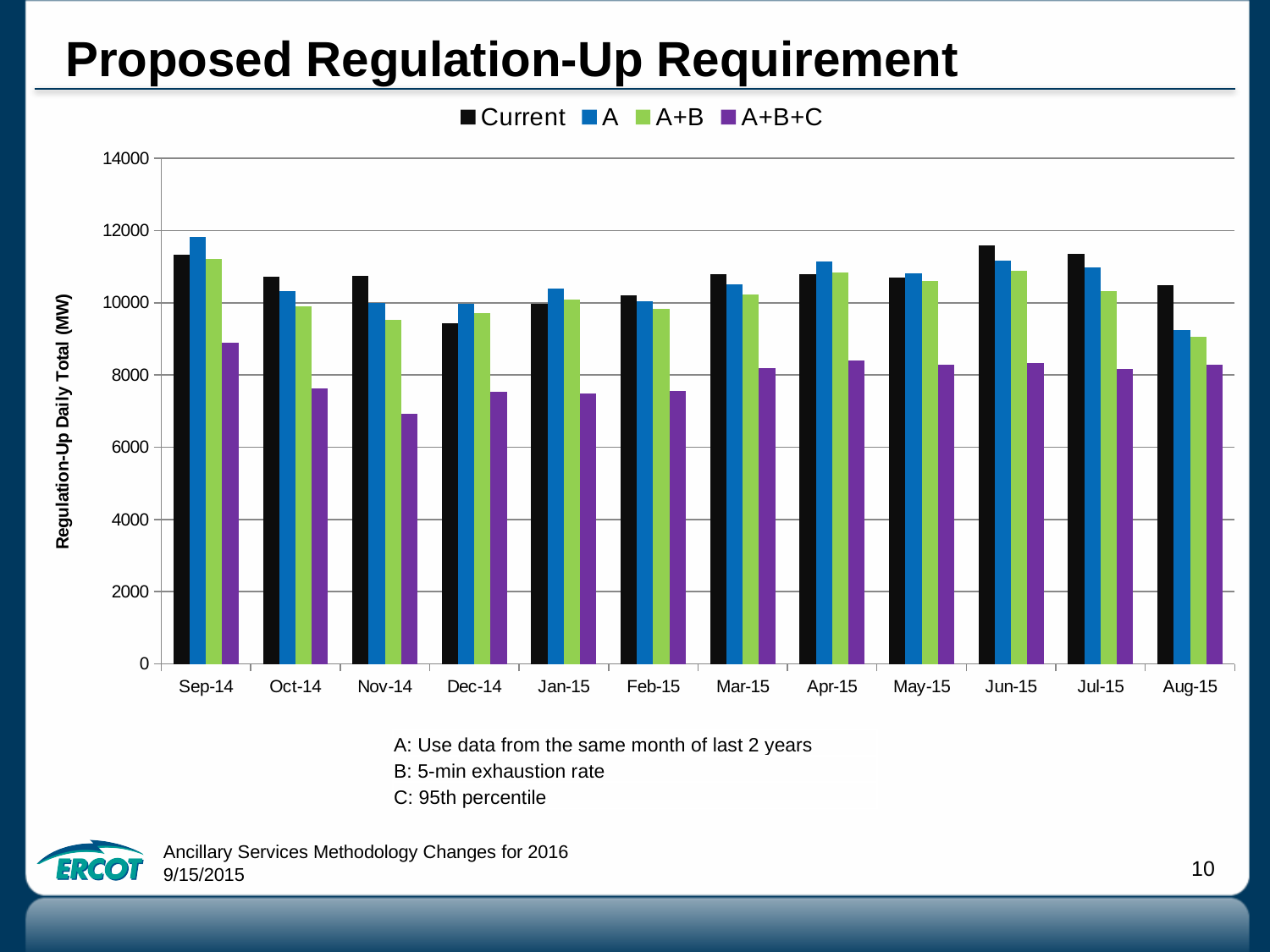
Is the A+B+C value for Nov-14 greater or less than 8000? less Is the value for series A in Aug-15 greater or less than 10000? less Which month has the lowest A+B+C value? Nov-14 Is the Current value for Sep-14 greater or less than 10000? greater What kind of chart is shown on the slide? bar chart How many series does the legend list? 4 How many months are shown on the x axis? 12 Which month has the lowest Current value? Dec-14 Which month has the highest A+B+C value? Sep-14 Which month has the highest value for series A? Sep-14 In Aug-15, which is larger: the Current value or the A value? Current What is the title of the y axis? Regulation-Up Daily Total (MW)